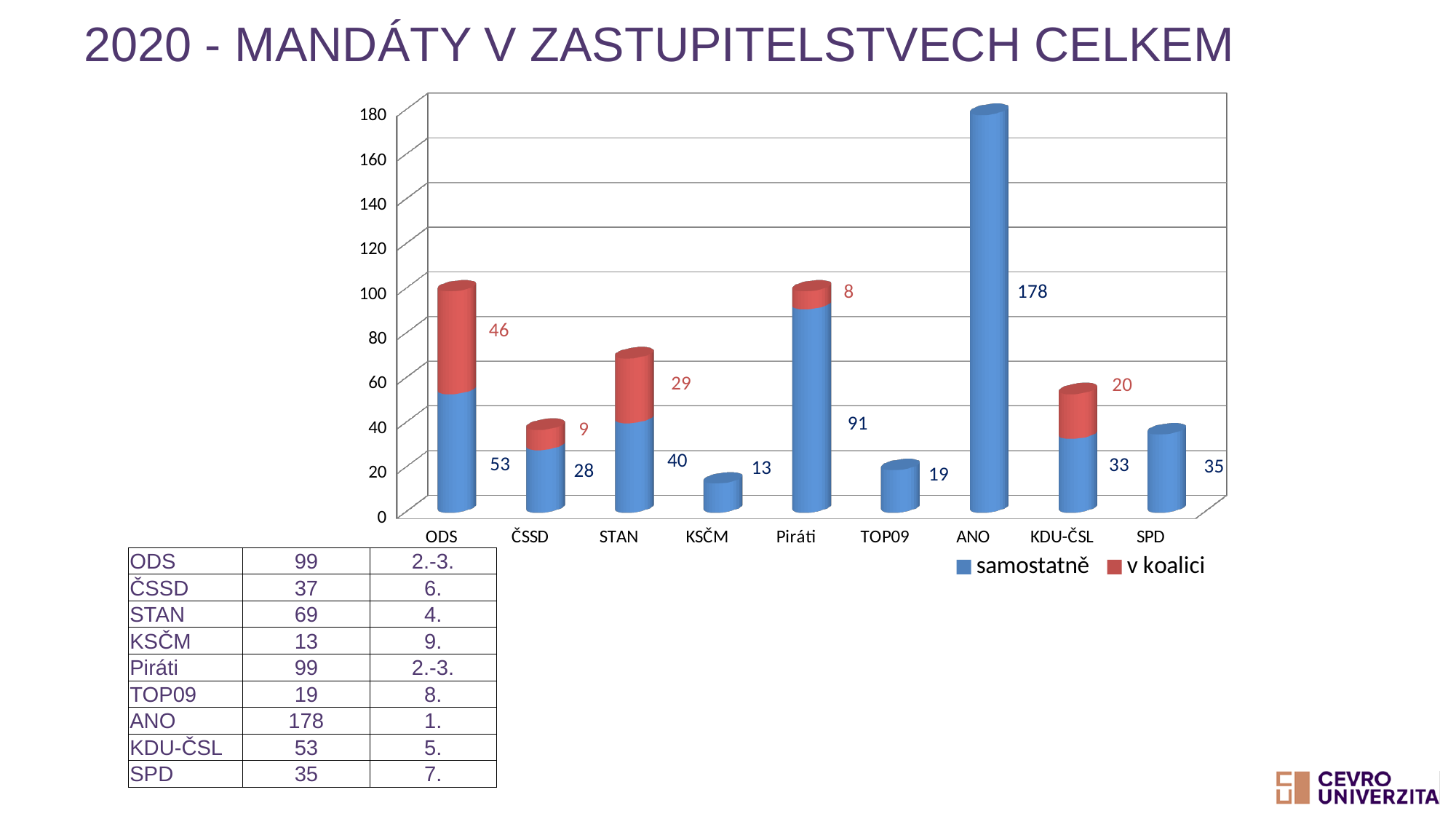
Which party has the lowest 'samostatně' value? KSČM Which party has the highest 'samostatně' value? ANO What is the 'v koalici' value for STAN? 29 Which is larger: the 'v koalici' value for ODS or for STAN? ODS What kind of chart is shown on the slide? Stacked bar chart What is the 'samostatně' value for ODS? 53 How many parties are shown on the x axis? 9 What is the 'samostatně' value for Piráti? 91 What is the difference between the 'samostatně' values for ANO and Piráti? 87 What is the total of the stacked bar for ODS? 99 What is the 'v koalici' value for KDU-ČSL? 20 How many series does the legend list? 2